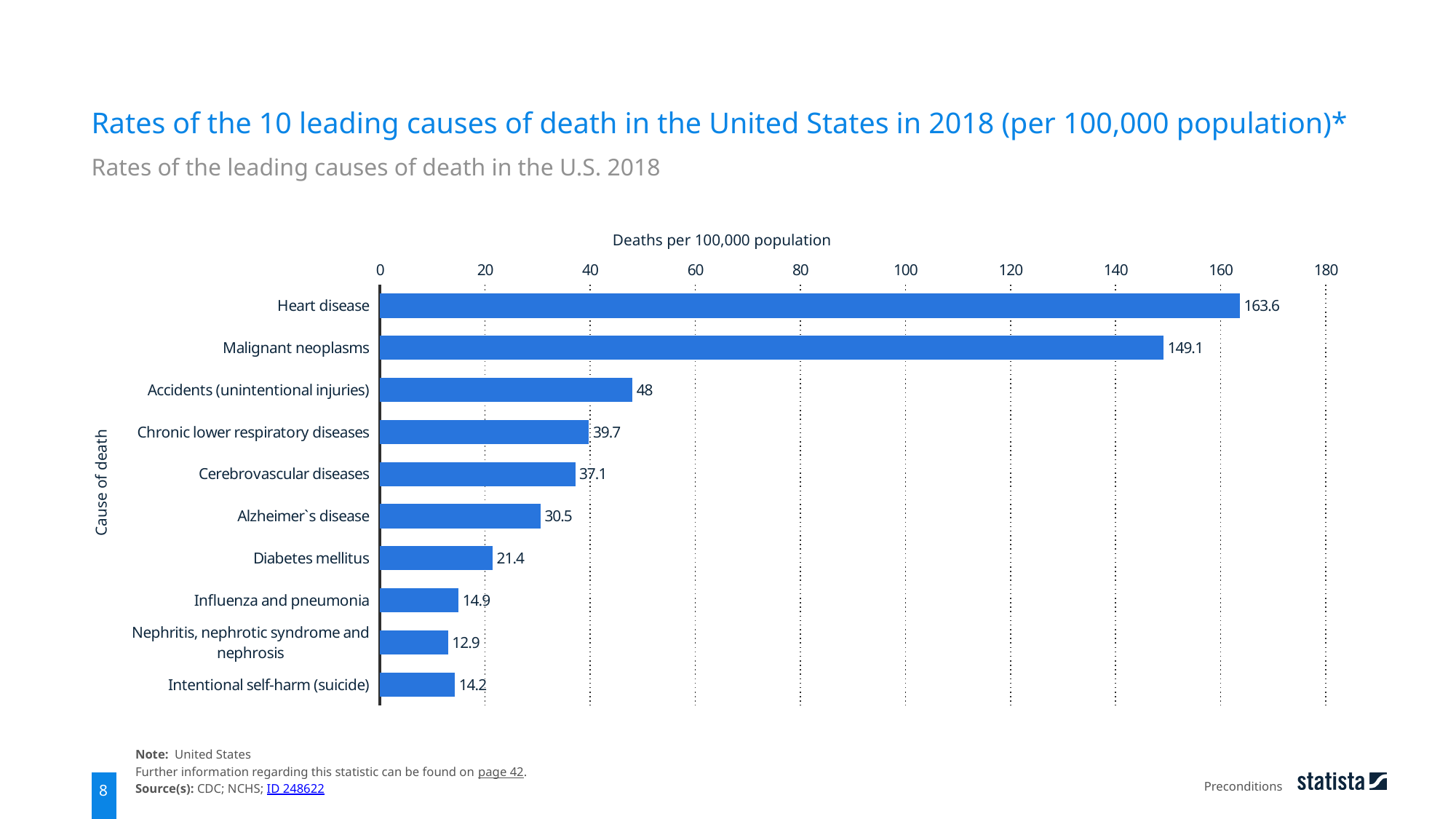
Which cause of death has the lowest rate? Nephritis, nephrotic syndrome and nephrosis What kind of chart is shown on the slide? Bar chart What is the difference between the death rates for heart disease and malignant neoplasms? 14.5 Is the value for malignant neoplasms greater or less than 140? greater Which cause of death has the highest rate? Heart disease What is the death rate per 100,000 population for heart disease? 163.6 What is the difference between the death rates for accidents (unintentional injuries) and diabetes mellitus? 26.6 What is the death rate per 100,000 population for Alzheimer`s disease? 30.5 What is the death rate per 100,000 population for nephritis, nephrotic syndrome and nephrosis? 12.9 How many causes of death are shown in the chart? 10 Which has a higher death rate, chronic lower respiratory diseases or cerebrovascular diseases? Chronic lower respiratory diseases What is the label of the horizontal axis of the chart? Deaths per 100,000 population